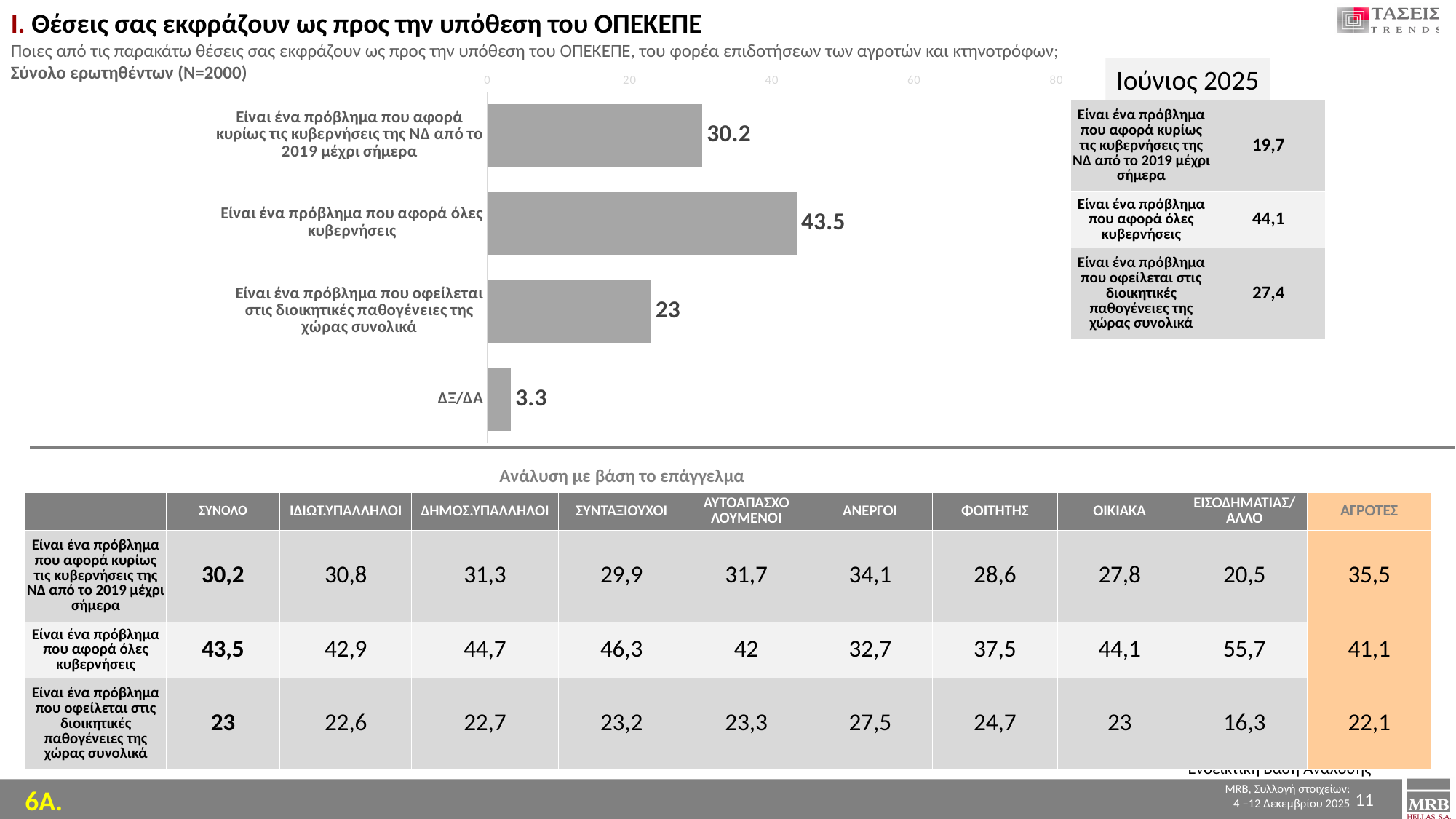
What is the difference between the value for "Είναι ένα πρόβλημα που αφορά όλες κυβερνήσεις" and the value for "Είναι ένα πρόβλημα που αφορά κυρίως τις κυβερνήσεις της ΝΔ από το 2019 μέχρι σήμερα"? 13.3 How many categories does the bar chart show? 4 Which category has the lowest value in the bar chart? ΔΞ/ΔΑ What is the highest tick value shown on the horizontal axis of the bar chart? 80 What is the value for "Είναι ένα πρόβλημα που οφείλεται στις διοικητικές παθογένειες της χώρας συνολικά" in the bar chart? 23 What is the value for ΔΞ/ΔΑ in the bar chart? 3.3 Is the value for "Είναι ένα πρόβλημα που αφορά όλες κυβερνήσεις" greater or less than 40? greater What is the value for "Είναι ένα πρόβλημα που αφορά όλες κυβερνήσεις" in the bar chart? 43.5 What kind of chart is shown on the slide? bar chart Which is larger in the bar chart: the value for "Είναι ένα πρόβλημα που οφείλεται στις διοικητικές παθογένειες της χώρας συνολικά" or the value for ΔΞ/ΔΑ? Είναι ένα πρόβλημα που οφείλεται στις διοικητικές παθογένειες της χώρας συνολικά What is the value for "Είναι ένα πρόβλημα που αφορά κυρίως τις κυβερνήσεις της ΝΔ από το 2019 μέχρι σήμερα" in the bar chart? 30.2 Which category has the highest value in the bar chart? Είναι ένα πρόβλημα που αφορά όλες κυβερνήσεις